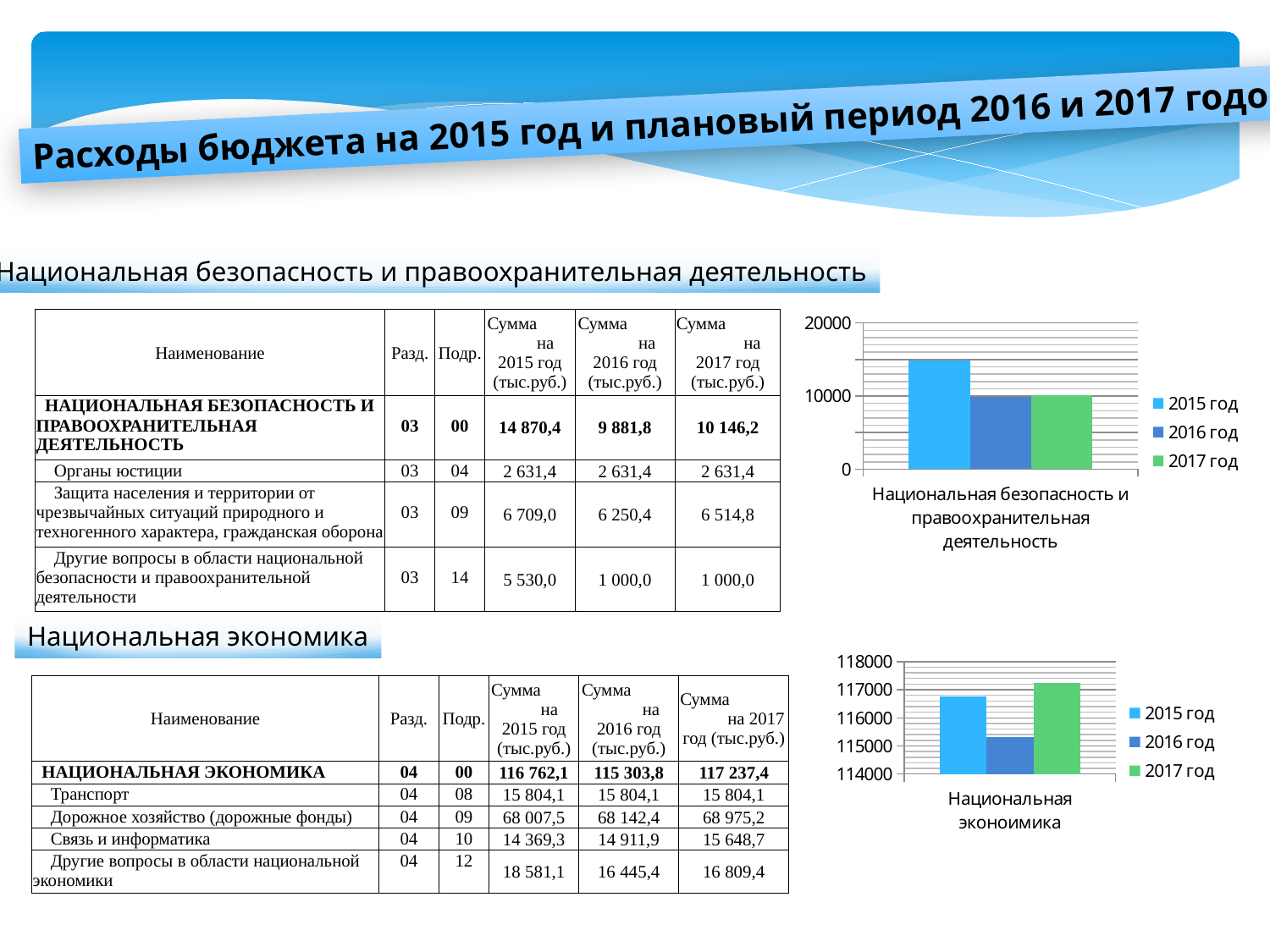
What kind of chart is the top chart on the slide (Национальная безопасность и правоохранительная деятельность)? bar chart In the top chart, which year has the tallest bar? 2015 год What kind of chart is the bottom chart on the slide (Национальная экономика)? bar chart In the bottom chart, is the value for 2017 год greater or less than 117000? greater In the top chart, is the value for 2016 год greater or less than 20000? less In the bottom chart, which year has the lowest bar? 2016 год What is the category label shown under the bars of the bottom chart? Национальная эконоимика How many series does the legend of the top chart list? 3 In the top chart, is the value for 2015 год greater or less than 10000? greater In the top chart, which is larger: the bar for 2015 год or the bar for 2017 год? 2015 год In the bottom chart, which year has the highest bar? 2017 год